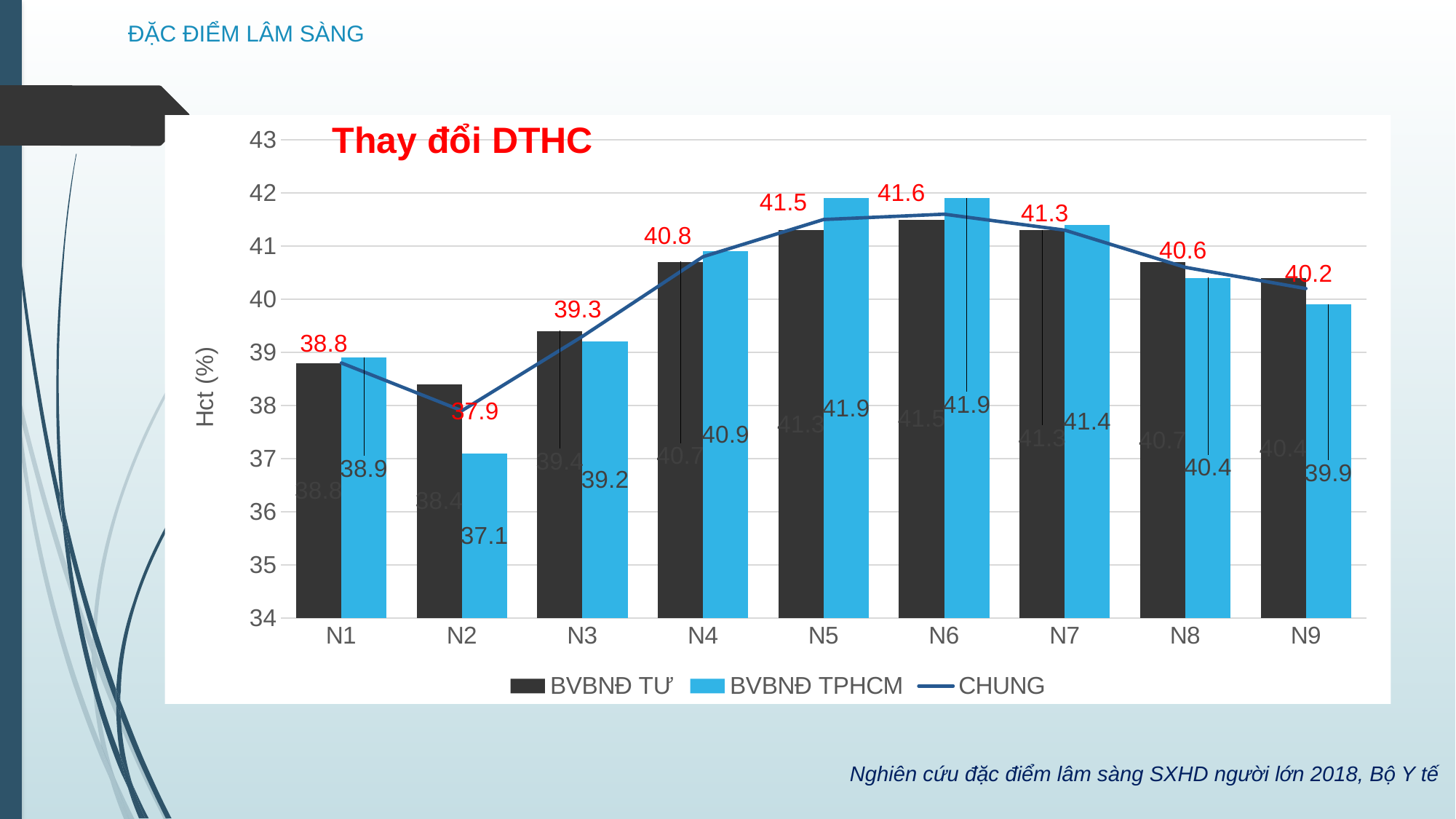
Is the BVBNĐ TPHCM value at N2 greater or less than 38? less What is the BVBNĐ TƯ value at N9? 40.4 What is the title of the chart? Thay đổi DTHC At which category is the BVBNĐ TPHCM value lowest? N2 How many series does the legend list? 3 What kind of chart is this? Combined bar and line chart What is the BVBNĐ TPHCM value at N5? 41.9 How many categories are shown on the x axis? 9 What is the difference between the BVBNĐ TƯ and BVBNĐ TPHCM values at N2? 1.3 At N5, which is larger: BVBNĐ TƯ or BVBNĐ TPHCM? BVBNĐ TPHCM At which category is the CHUNG line highest? N6 What is the CHUNG value at N2? 37.9